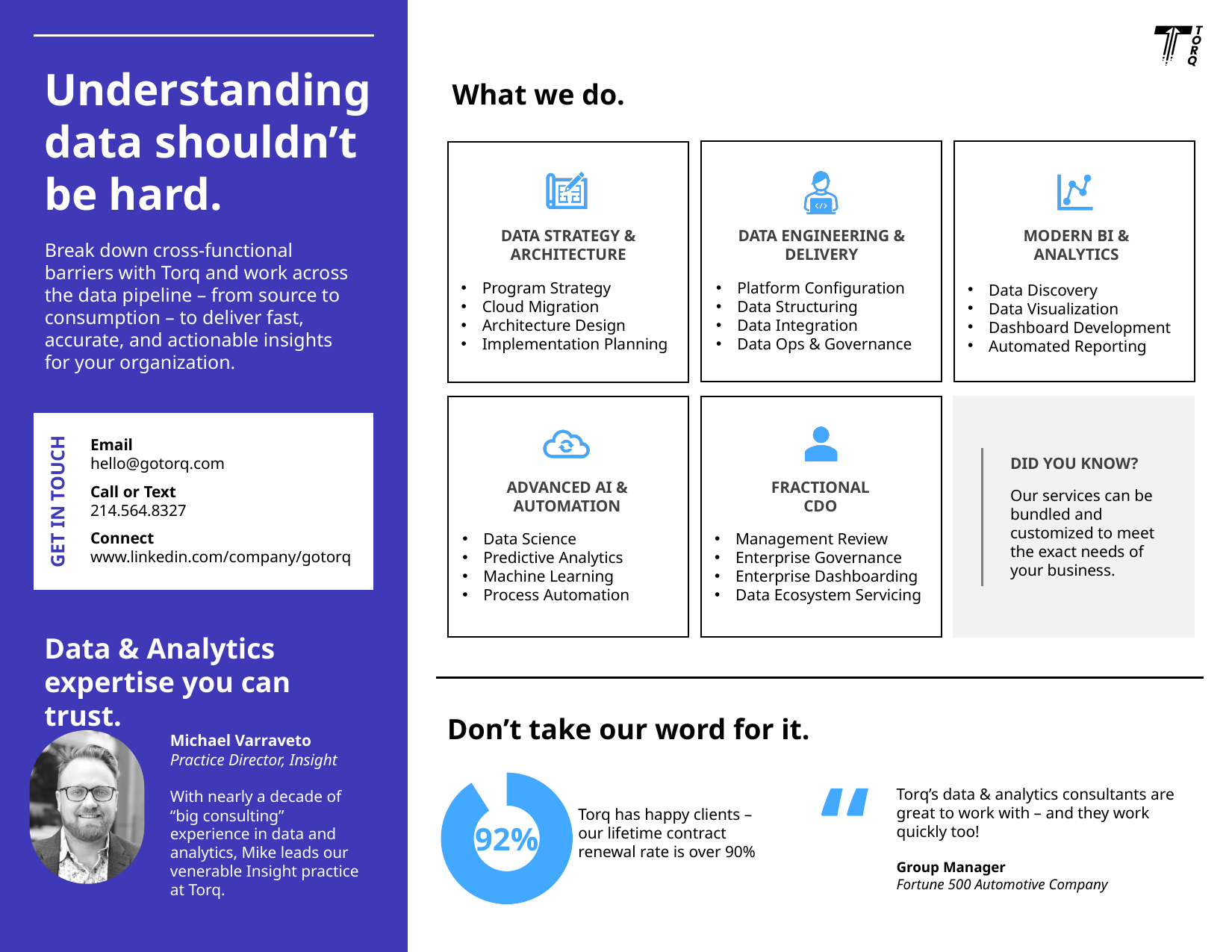
What kind of chart is shown in the "Don't take our word for it." section? Donut chart What colour is the filled segment of the donut chart? Blue How many segments does the donut chart have? 2 Which segment of the donut chart is larger, the filled blue segment or the gap? The filled blue segment What percentage is printed in the centre of the donut chart? 92% Is the value shown in the donut chart greater or less than 50%? greater Is the value shown in the donut chart greater or less than 90%? greater What does the 92% in the donut chart represent, according to the text beside it? Lifetime contract renewal rate